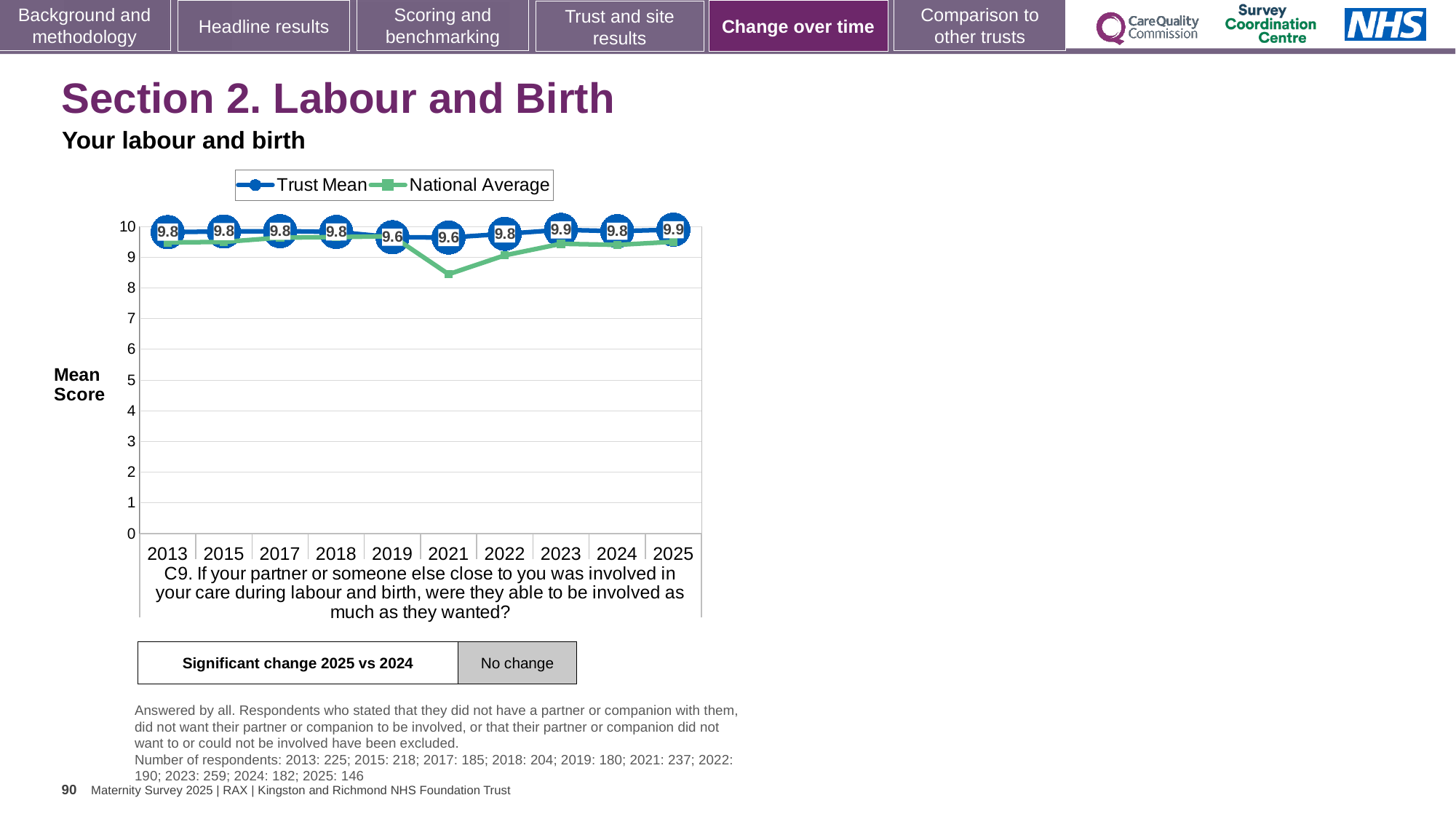
What is the difference between the Trust Mean in 2023 and the Trust Mean in 2021? 0.3 Does the Trust Mean rise or fall from 2021 to 2023? rise What is the Trust Mean for 2013? 9.8 Is the National Average for 2021 greater or less than 9? less What kind of chart is shown on the slide? line chart What is the lowest Trust Mean value shown on the chart? 9.6 What is the Trust Mean for 2025? 9.9 How many survey years are plotted on the x axis? 10 How many series does the legend list? 2 What is the Trust Mean for 2019? 9.6 What is the label on the y axis of the chart? Mean Score Which year has the larger Trust Mean, 2021 or 2023? 2023